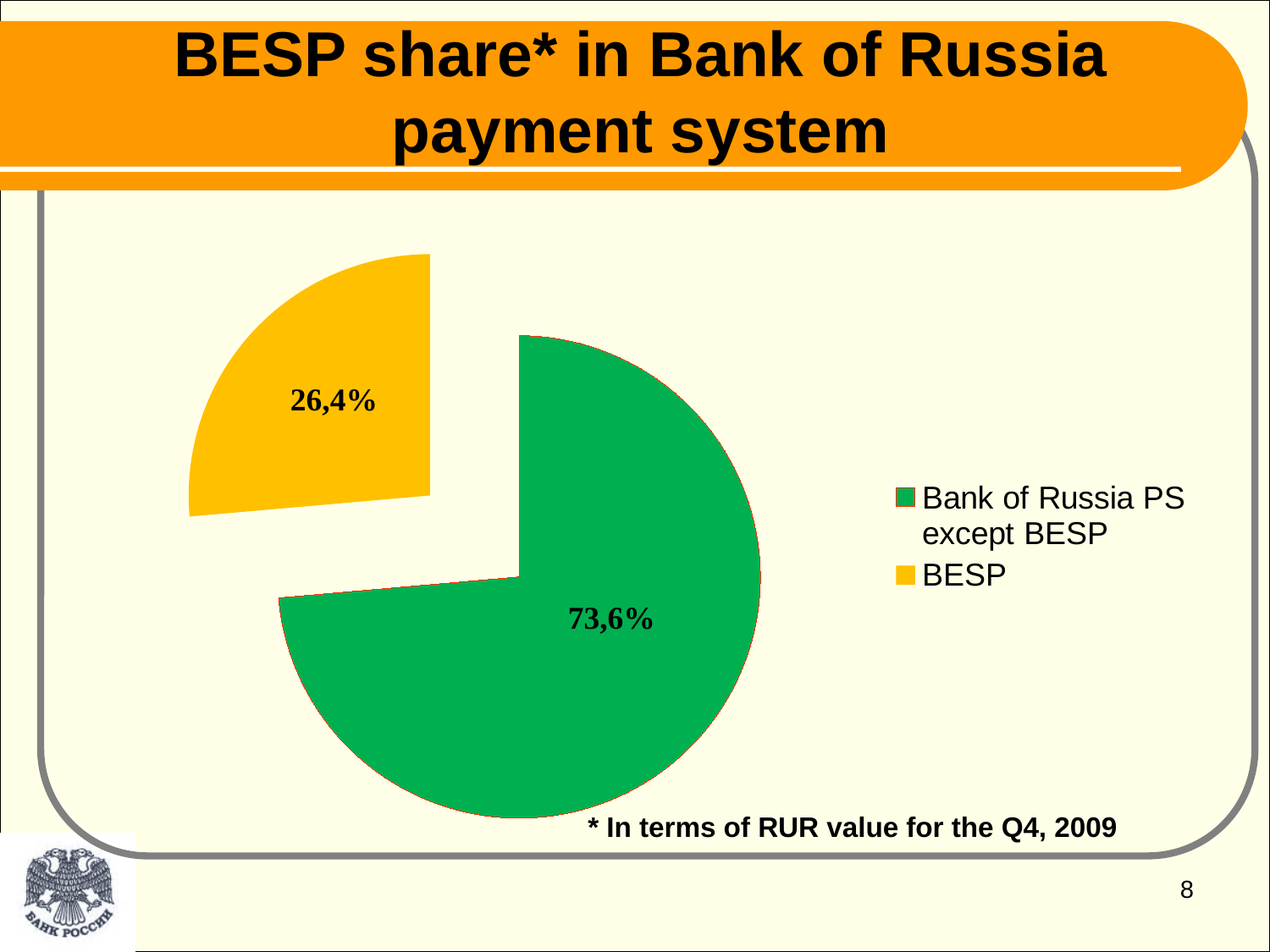
What colour is the BESP slice? yellow What share of the pie does Bank of Russia PS except BESP represent? 73,6% How many entries does the legend list? 2 Which slice of the pie is the smallest? BESP What is the difference in percentage points between the Bank of Russia PS except BESP slice and the BESP slice? 47,2 Which slice of the pie is the largest? Bank of Russia PS except BESP What share of the pie does BESP represent? 26,4% Which is larger, the BESP slice or the Bank of Russia PS except BESP slice? Bank of Russia PS except BESP How many slices does the pie chart have? 2 What kind of chart is shown on the slide? pie chart What is the title of the slide containing the chart? BESP share* in Bank of Russia payment system